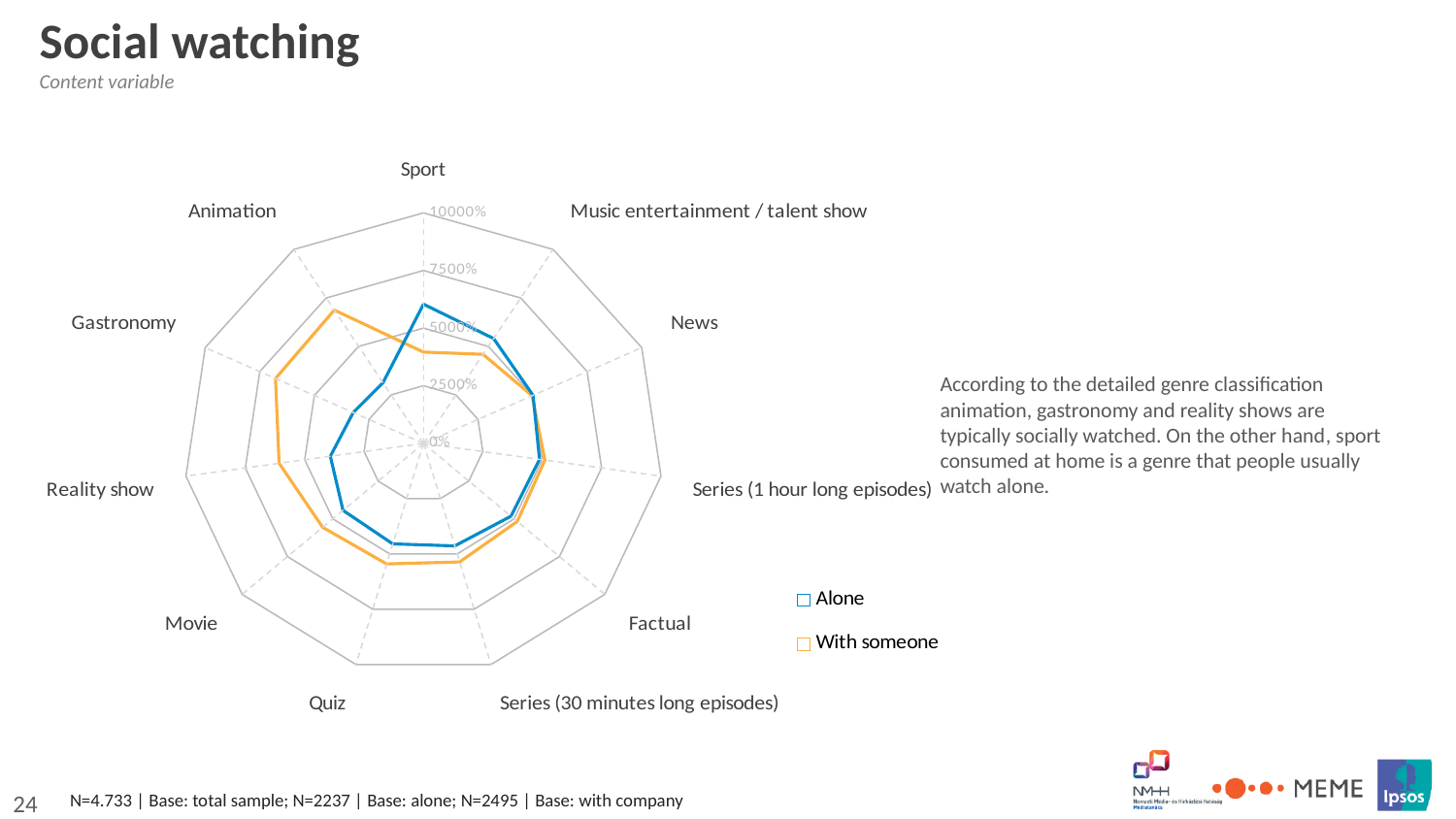
Which series is drawn in orange on the chart? With someone Which series is drawn in blue on the chart? Alone For Reality show, which series has the larger value, Alone or With someone? With someone Which genre has the highest value for the Alone series? Sport For Gastronomy, which series has the larger value, Alone or With someone? With someone How many genre categories are plotted on the radar chart? 11 For Movie, which series has the larger value, Alone or With someone? With someone Is the Alone value for Sport greater or less than 5000%? greater Is the With someone value for Gastronomy greater or less than 5000%? greater What kind of chart is shown on the slide? Radar chart How many series does the chart legend list? 2